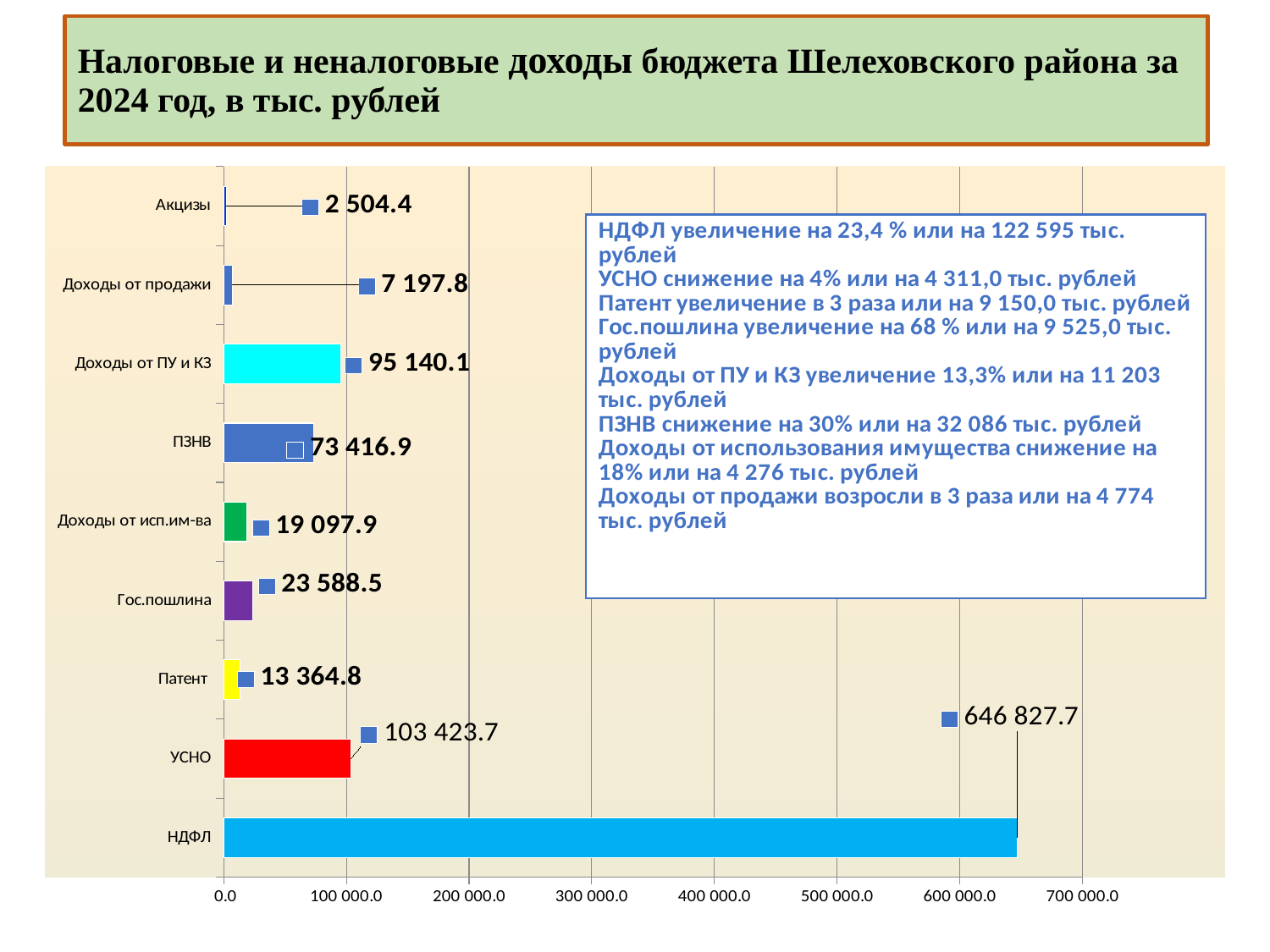
Which category has the highest value? НДФЛ What is the value for УСНО? 103 423.7 Which category has the lowest value? Акцизы What is the title of the slide? Налоговые и неналоговые доходы бюджета Шелеховского района за 2024 год, в тыс. рублей What is the value for Гос.пошлина? 23 588.5 What is the value for Патент? 13 364.8 What is the difference between the values for УСНО and Доходы от ПУ и КЗ? 8 283.6 How many categories are shown in the chart? 9 What is the value for Акцизы? 2 504.4 What kind of chart is shown on the slide? Bar chart Which is larger, the value for ПЗНВ or the value for Доходы от исп.им-ва? ПЗНВ What is the value for НДФЛ? 646 827.7